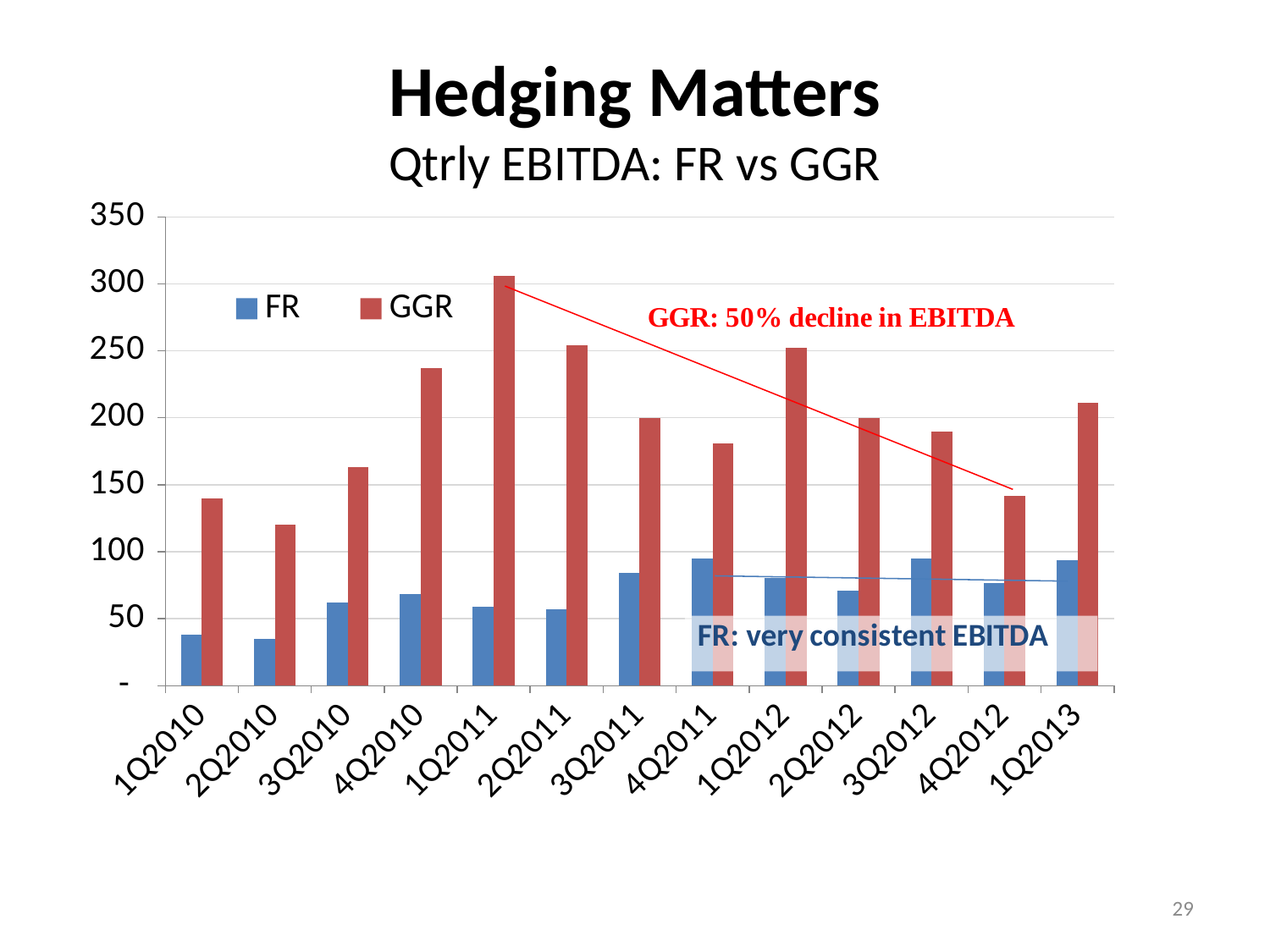
How many quarters are shown on the x axis? 13 Which is larger, the GGR value for 1Q2011 or the GGR value for 1Q2012? 1Q2011 Is the GGR value for 4Q2010 greater or less than 200? greater Which is larger in 1Q2010, the FR value or the GGR value? GGR Is the GGR value for 2Q2010 greater or less than 150? less In which quarter is the GGR EBITDA highest? 1Q2011 How many series does the legend list? 2 What kind of chart is shown on the slide? Bar chart Is the FR value for 4Q2011 greater or less than 50? greater In which quarter is the GGR EBITDA lowest? 2Q2010 Which colour represents the GGR series? Red What is the subtitle of the chart? Qtrly EBITDA: FR vs GGR